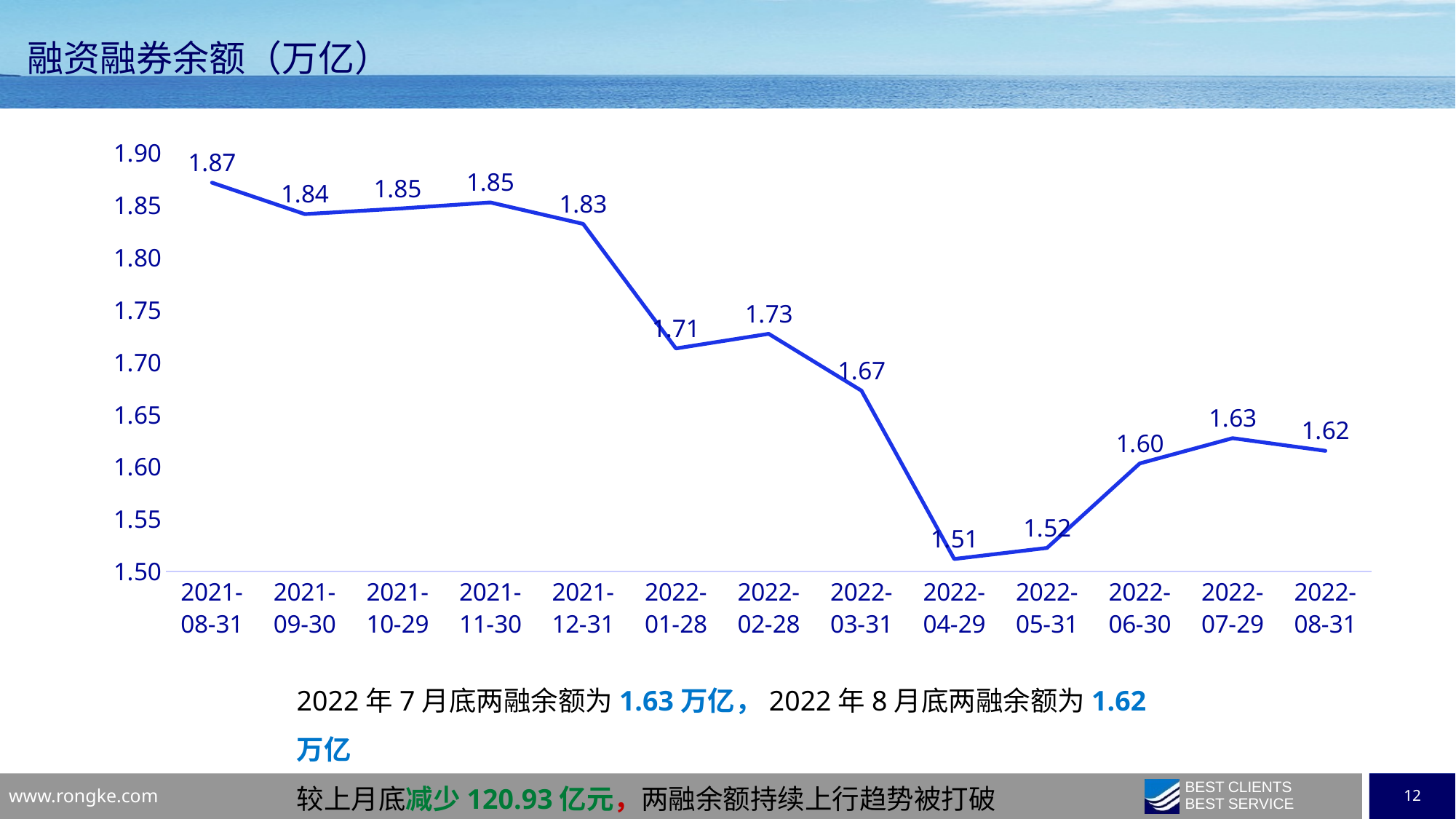
What is the value for 2022-08-31? 1.62 What is the value for 2022-01-28? 1.71 Which date has the lowest value? 2022-04-29 What is the difference between the values for 2022-07-29 and 2022-08-31? 0.01 What is the title of the chart? 融资融券余额（万亿） What kind of chart is shown on the slide? line chart What is the difference between the values for 2021-08-31 and 2022-04-29? 0.36 How many data points are plotted on the chart? 13 Which is larger, the value for 2022-02-28 or the value for 2022-03-31? 2022-02-28 What is the value for 2021-08-31? 1.87 What is the value for 2022-04-29? 1.51 Which date has the highest value? 2021-08-31